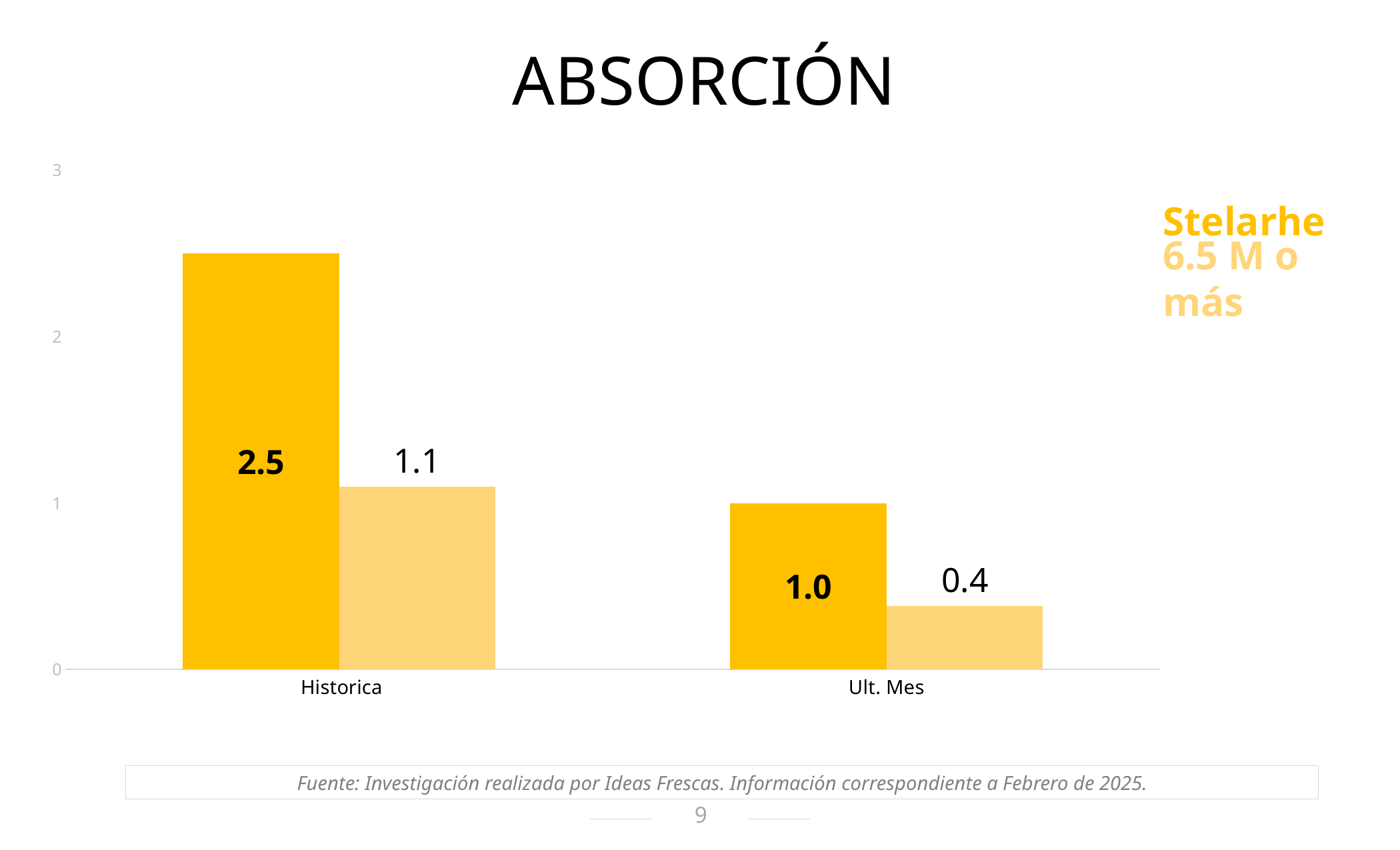
Which is larger in the Ult. Mes category, Stelarhe or 6.5 M o más? Stelarhe What type of chart is shown on the slide? Bar chart Which category has the lowest 6.5 M o más value? Ult. Mes Which category has the highest Stelarhe value? Historica How many categories are shown on the x axis? 2 What is the value for Stelarhe in the Ult. Mes category? 1.0 What is the value for Stelarhe in the Historica category? 2.5 How many series does the chart show? 2 What is the value for 6.5 M o más in the Ult. Mes category? 0.4 What is the difference between the Stelarhe and 6.5 M o más values in the Historica category? 1.4 What is the value for 6.5 M o más in the Historica category? 1.1 What is the difference between the Stelarhe values for Historica and Ult. Mes? 1.5